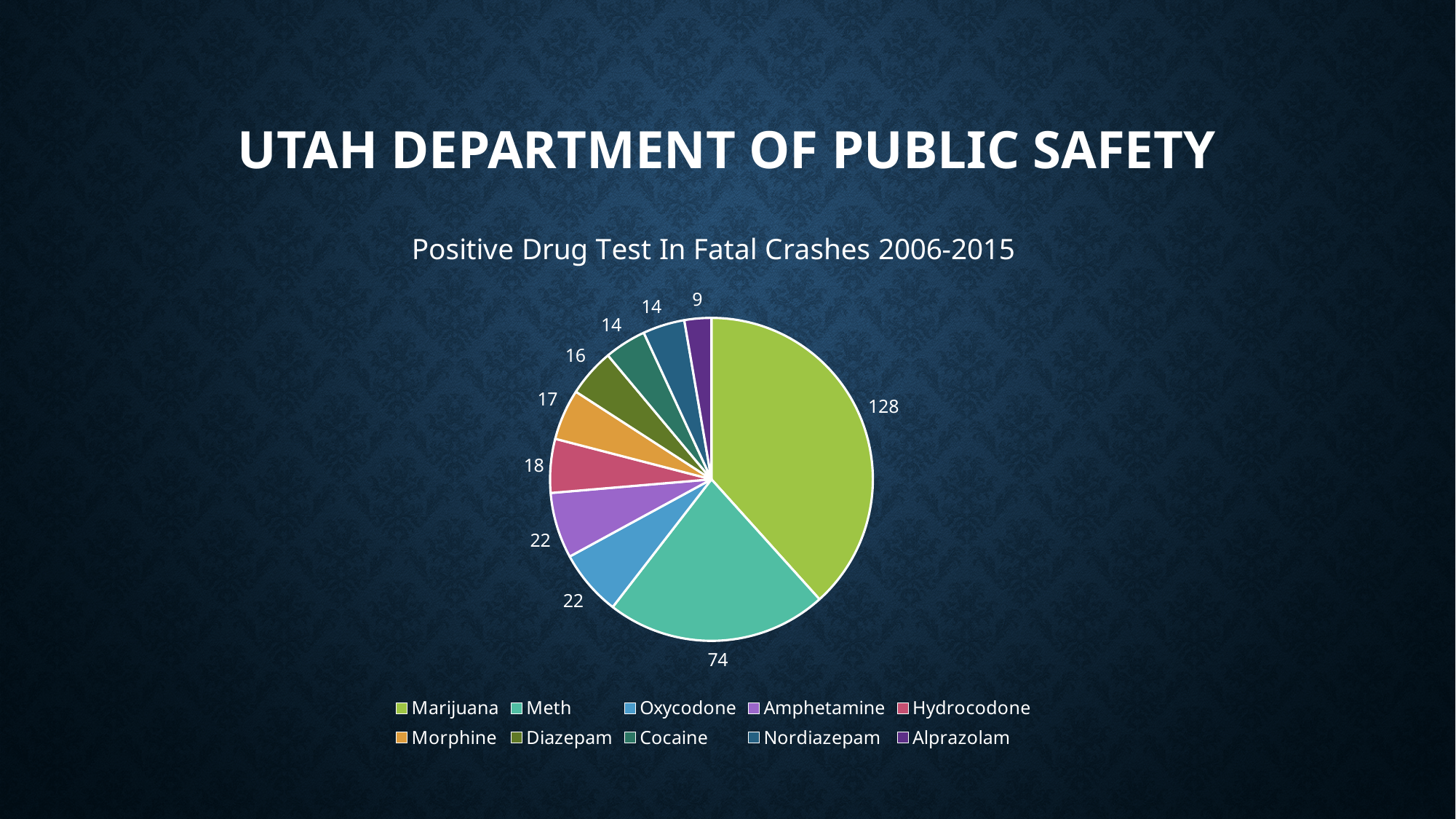
What is the title of the chart? Positive Drug Test In Fatal Crashes 2006-2015 Which drug has the smallest slice of the pie? Alprazolam What is the value for Hydrocodone? 18 What kind of chart is shown on the slide? Pie chart What share of the pie does Marijuana represent, to the nearest whole percent? 38% What is the value for Alprazolam? 9 Which drug has the largest slice of the pie? Marijuana Which is larger, the value for Morphine or the value for Diazepam? Morphine What is the difference between the values for Marijuana and Meth? 54 How many categories does the legend list? 10 What is the value for Meth? 74 What is the value for Marijuana? 128